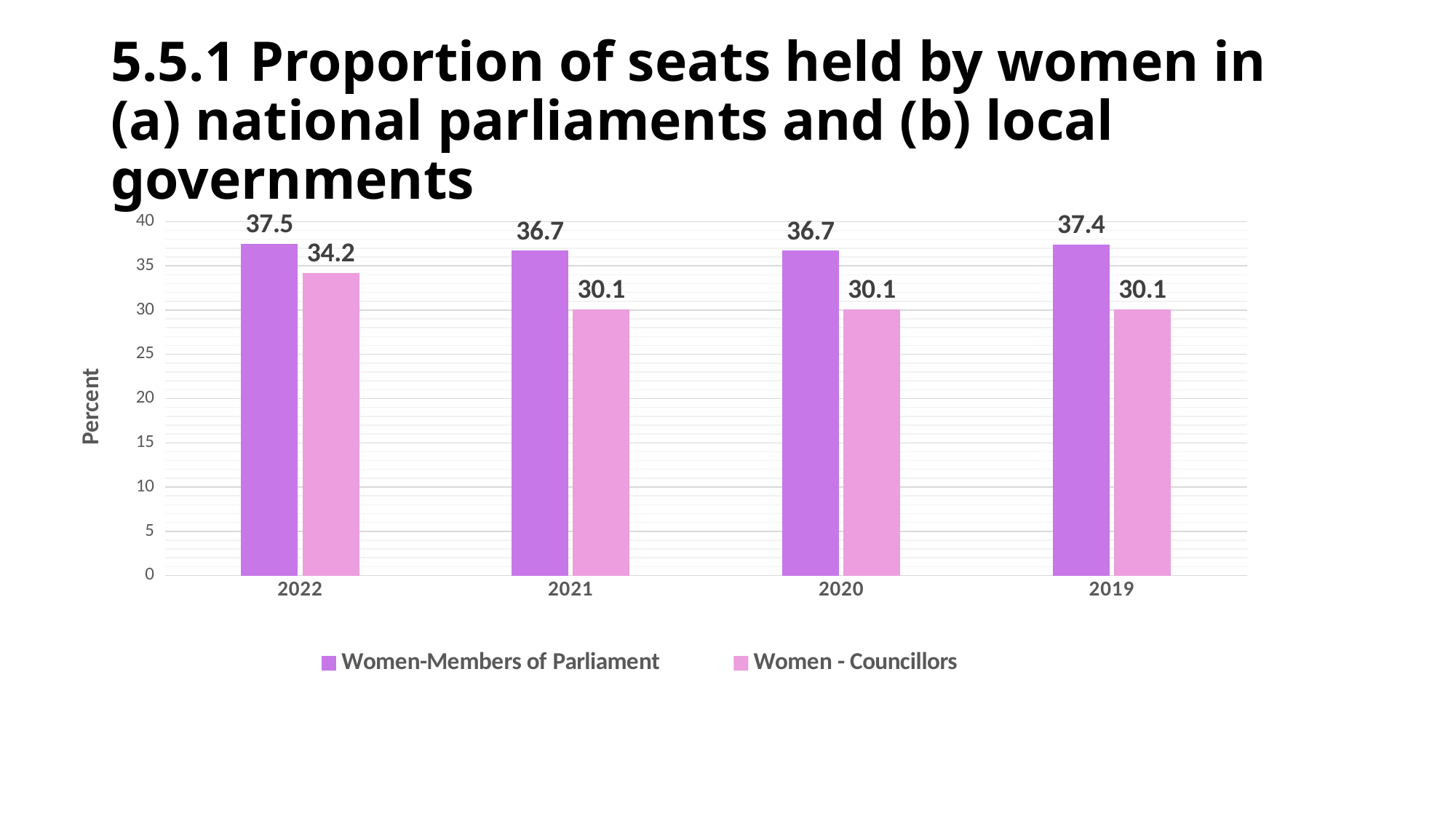
What is the difference between the Women-Members of Parliament values in 2022 and 2021? 0.8 How many series does the legend list? 2 What kind of chart is shown on the slide? Bar chart What is the value for Women-Members of Parliament in 2019? 37.4 In which year is the Women - Councillors value highest? 2022 What is the value for Women - Councillors in 2020? 30.1 What is the label on the vertical axis? Percent What is the value for Women - Councillors in 2022? 34.2 How many years are shown on the x axis? 4 What is the value for Women-Members of Parliament in 2022? 37.5 Which is larger in 2019: Women-Members of Parliament or Women - Councillors? Women-Members of Parliament What is the difference between the Women-Members of Parliament and Women - Councillors values in 2021? 6.6